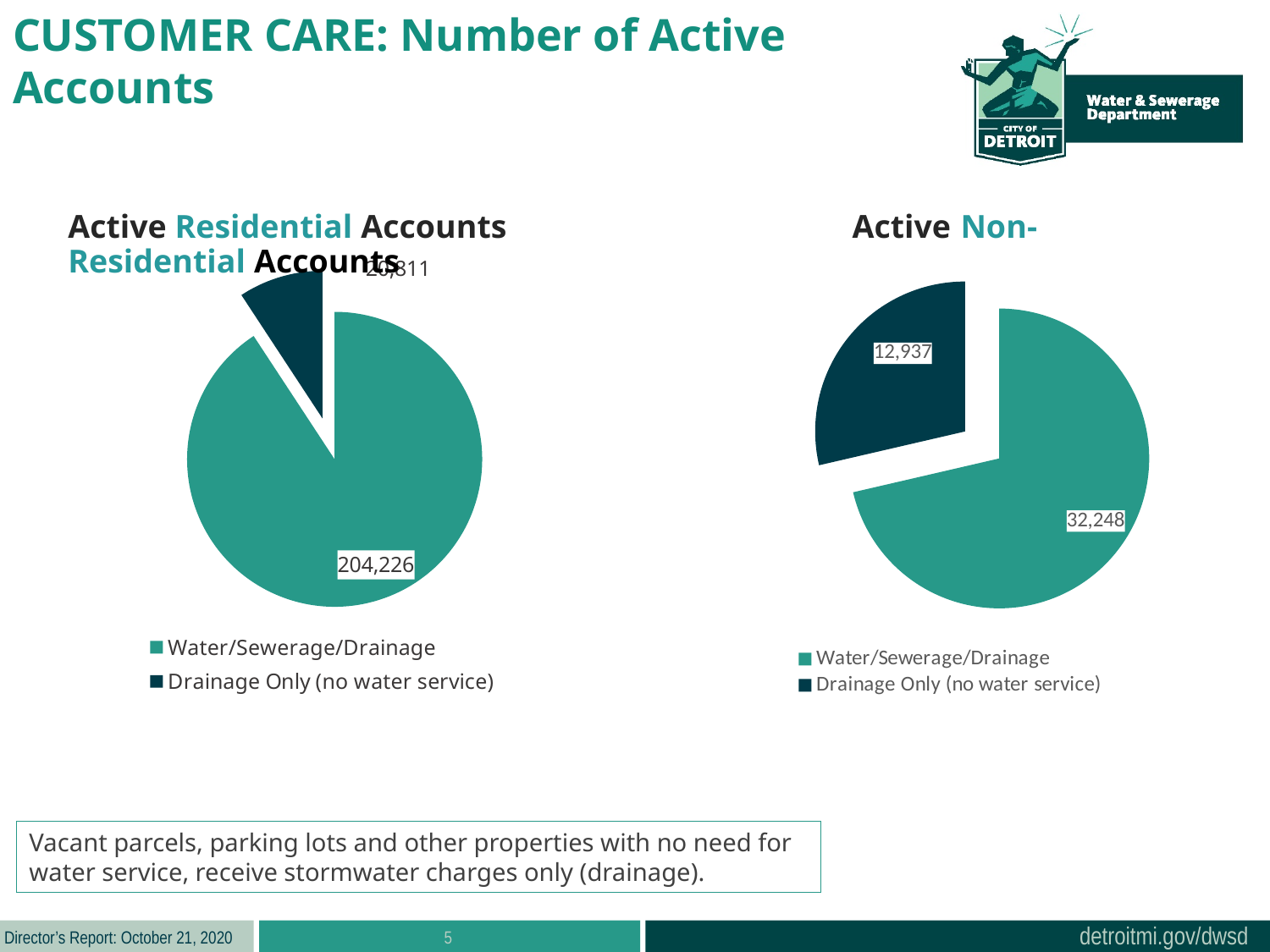
In the Active Non-Residential Accounts chart, which category has the largest slice? Water/Sewerage/Drainage In the Active Non-Residential Accounts chart, which is larger: Water/Sewerage/Drainage or Drainage Only (no water service)? Water/Sewerage/Drainage In the Active Non-Residential Accounts chart, what is the total of the two slices? 45,185 How many charts are shown on the slide? 2 In the Active Non-Residential Accounts chart, what is the value for Water/Sewerage/Drainage? 32,248 How many slices does the Active Non-Residential Accounts chart have? 2 In the Active Residential Accounts chart, what is the value for Water/Sewerage/Drainage? 204,226 In the Active Non-Residential Accounts chart, what is the difference between the Water/Sewerage/Drainage and Drainage Only (no water service) values? 19,311 How many entries does the legend of the Active Residential Accounts chart list? 2 What kind of chart is the Active Residential Accounts chart? Pie chart In the Active Non-Residential Accounts chart, what is the value for Drainage Only (no water service)? 12,937 In the Active Residential Accounts chart, which category has the smallest slice? Drainage Only (no water service)